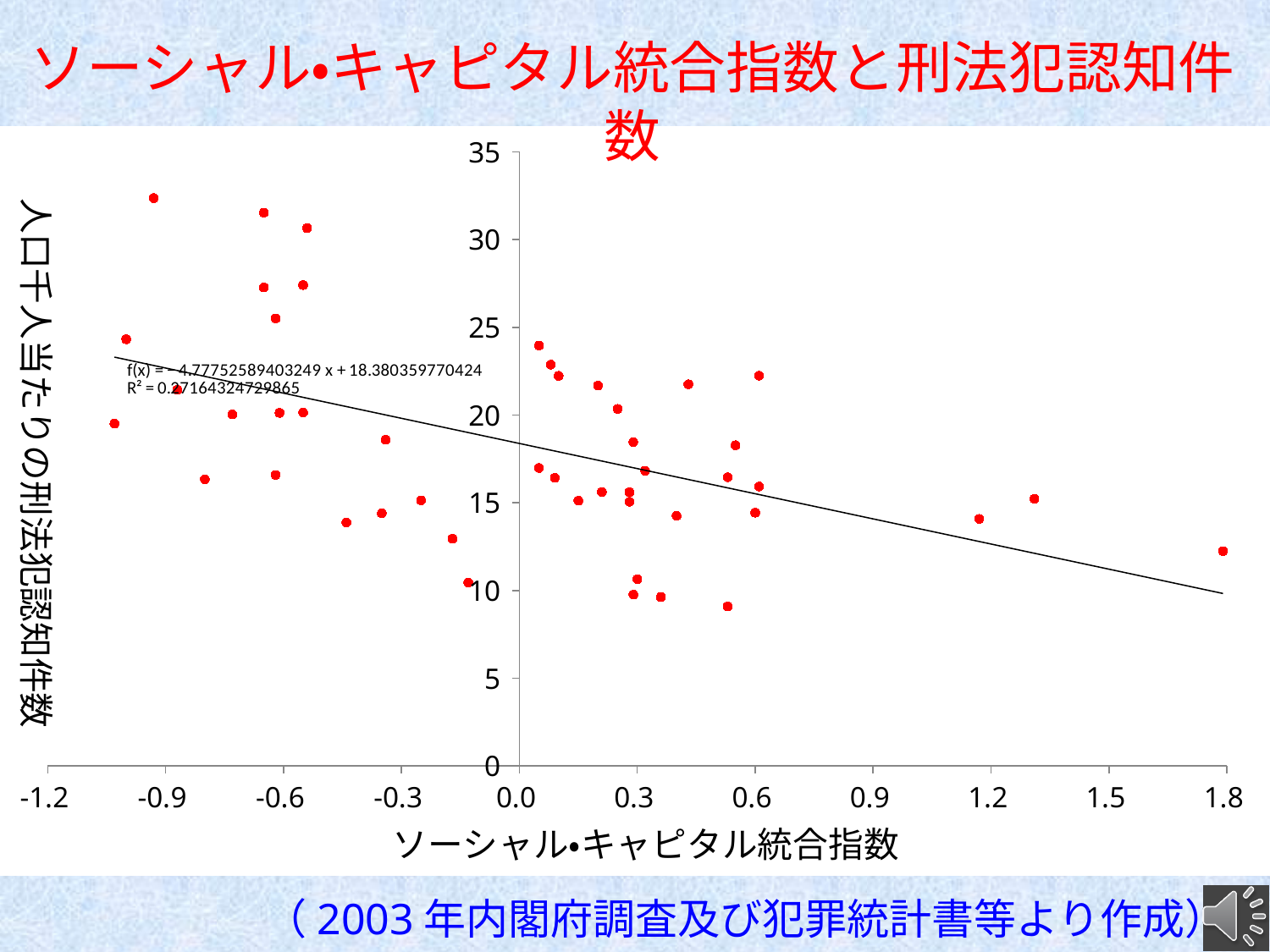
What is the maximum value shown on the y axis? 35 What is the label of the x axis? ソーシャル•キャピタル統合指数 Is the y value of the lowest point on the chart greater or less than 10? less Is the y value of the highest point on the chart greater or less than 30? greater Is the y value of the point near x = -0.9 at the top left greater or less than 30? greater As the ソーシャル•キャピタル統合指数 increases along the x axis, does the trend line rise or fall? fall What kind of chart is shown on the slide? scatter plot What is the R² value printed on the chart? 0.27164324729865 What is the intercept of the fitted line f(x) shown on the chart? 18.380359770424 What is the slope of the fitted line f(x) shown on the chart? -4.77752589403249